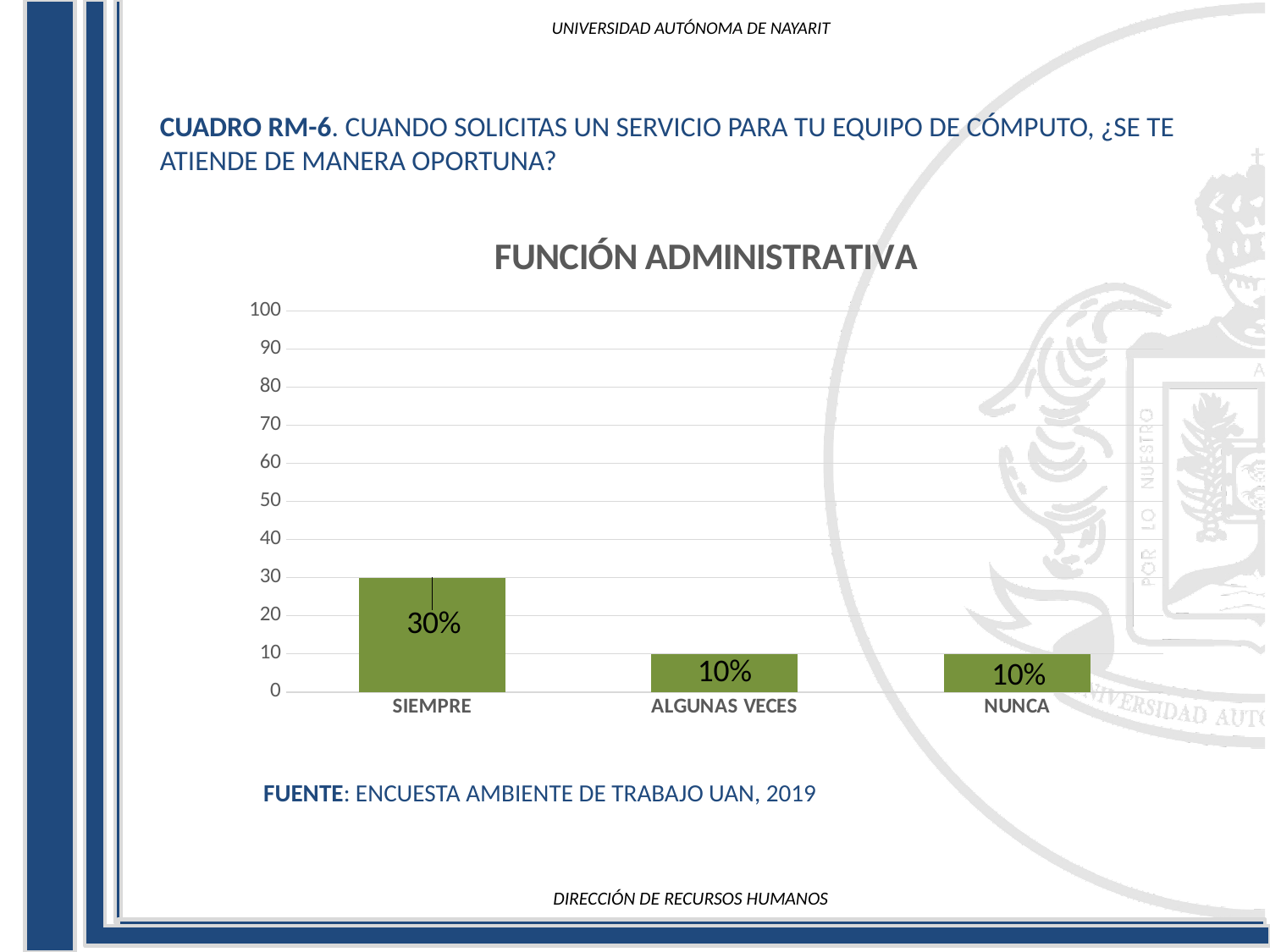
What is the value for NUNCA? 10% Is the value for NUNCA greater or less than 50? less What is the title of the chart? FUNCIÓN ADMINISTRATIVA How many categories are shown on the x axis? 3 Which is larger, the value for SIEMPRE or the value for NUNCA? SIEMPRE What is the highest value shown on the vertical axis? 100 What is the value for ALGUNAS VECES? 10% Is the value for SIEMPRE greater or less than 20? greater What is the value for SIEMPRE? 30% Which category has the highest value? SIEMPRE What is the difference between the values for SIEMPRE and ALGUNAS VECES? 20% What kind of chart is shown? bar chart